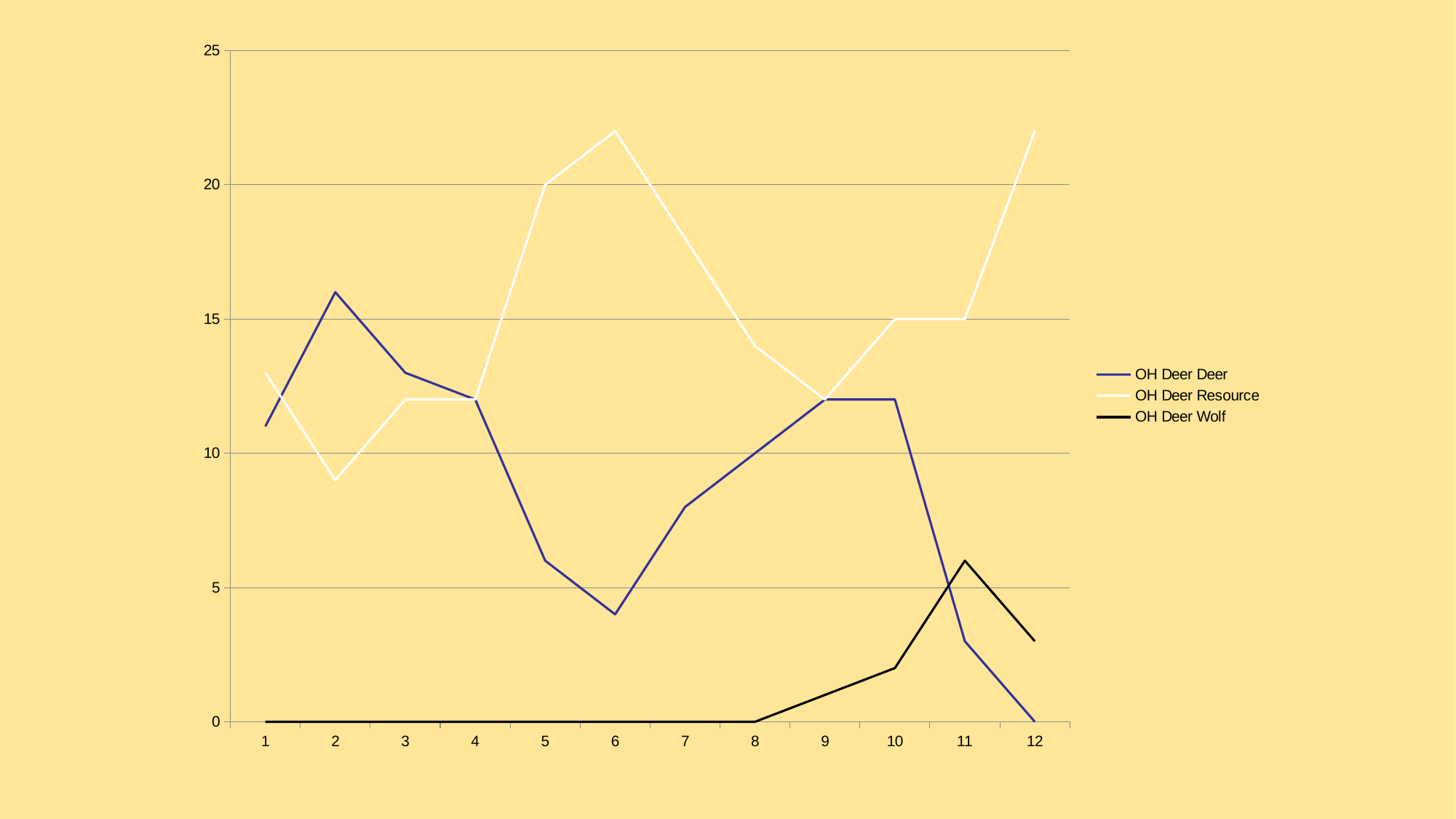
At which x value does OH Deer Wolf reach its highest point? 11 At x = 5, which series has the larger value, OH Deer Deer or OH Deer Resource? OH Deer Resource What is the value of OH Deer Resource at x = 5? 20 At which x value does OH Deer Deer reach its highest point? 2 What is the value of OH Deer Resource at x = 10? 15 Is the value for OH Deer Resource at x = 6 greater or less than 20? greater What kind of chart is shown on the slide? line chart Is the value for OH Deer Deer at x = 6 greater or less than 5? less What is the value of OH Deer Deer at x = 12? 0 How many points are plotted along the x axis for each series? 12 How many series does the legend list? 3 What is the value of OH Deer Wolf at x = 4? 0